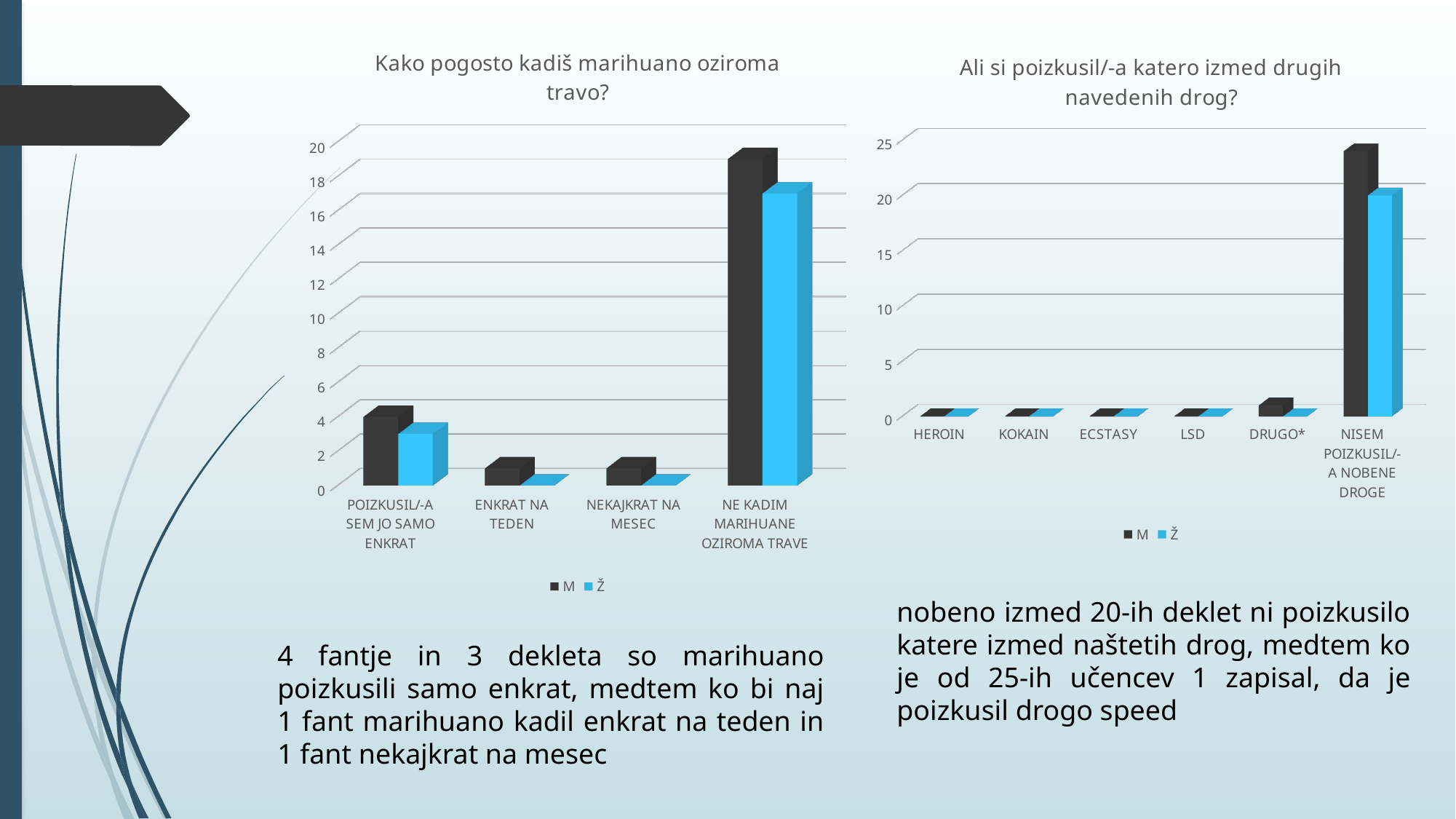
In the left chart, is the M value for NE KADIM MARIHUANE OZIROMA TRAVE greater or less than 15? greater What kind of chart is the left chart titled "Kako pogosto kadiš marihuano oziroma travo?"? bar chart In the left chart, which category has the highest value for the M series? NE KADIM MARIHUANE OZIROMA TRAVE What are the two legend entries of the left chart? M and Ž How many series does the legend of the right chart list? 2 In the right chart, is the M value for NISEM POIZKUSIL/-A NOBENE DROGE greater or less than 20? greater In the left chart, is the M value for POIZKUSIL/-A SEM JO SAMO ENKRAT greater or less than 10? less How many categories are shown on the x axis of the left chart ("Kako pogosto kadiš marihuano oziroma travo?")? 4 In the right chart, which category has the highest value for the Ž series? NISEM POIZKUSIL/-A NOBENE DROGE In the left chart, for NE KADIM MARIHUANE OZIROMA TRAVE, which series has the larger value, M or Ž? M How many categories are shown on the x axis of the right chart ("Ali si poizkusil/-a katero izmed drugih navedenih drog?")? 6